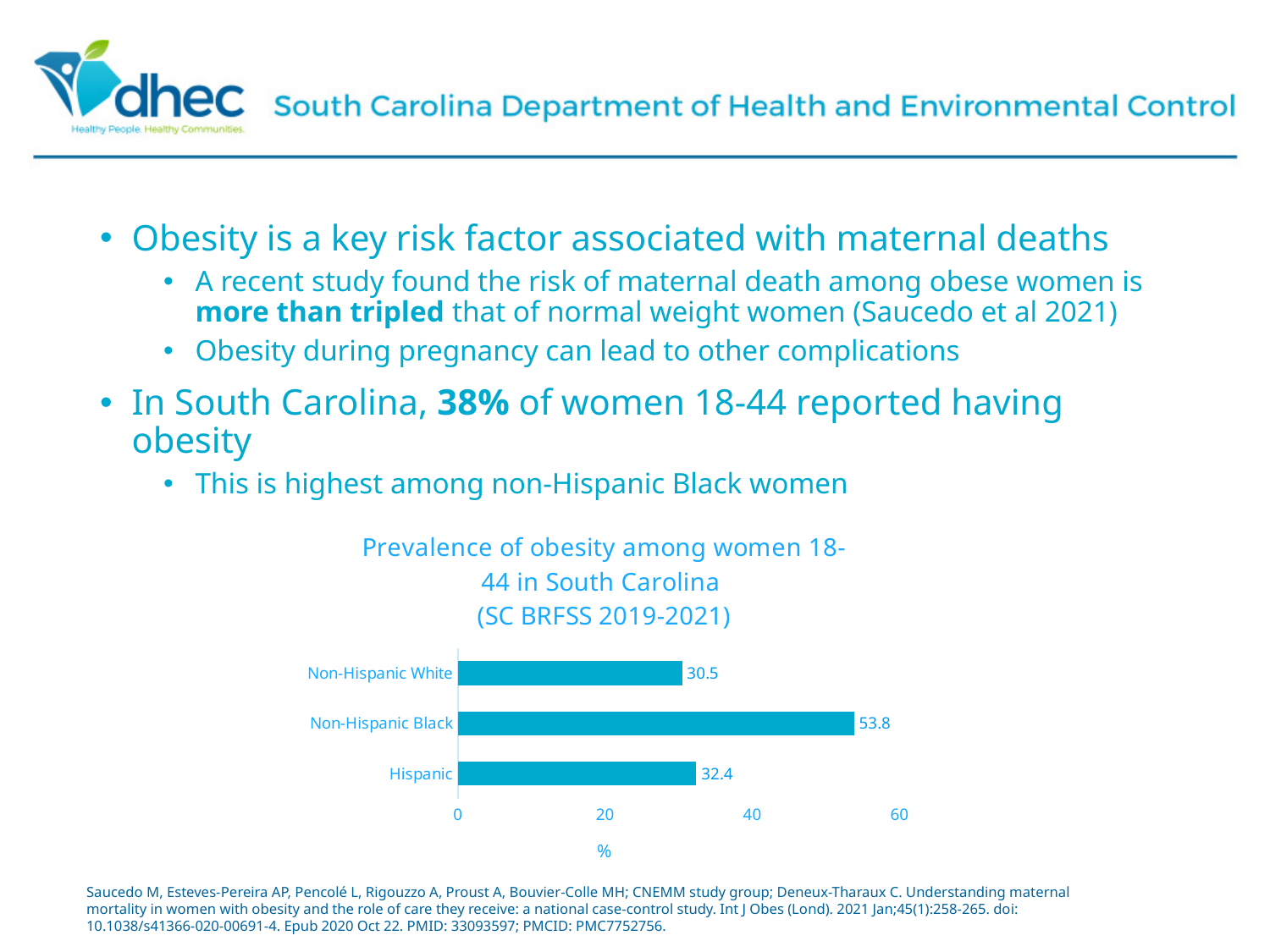
Is the value for Non-Hispanic Black women greater or less than 40? greater What is the prevalence of obesity among Non-Hispanic Black women in the chart? 53.8 How many groups are shown in the chart? 3 What is the difference between the values for Hispanic and Non-Hispanic White women? 1.9 What is the prevalence of obesity among Hispanic women in the chart? 32.4 What is the difference between the values for Non-Hispanic Black and Non-Hispanic White women? 23.3 What is the prevalence of obesity among Non-Hispanic White women in the chart? 30.5 Which is larger, the value for Hispanic women or the value for Non-Hispanic White women? Hispanic What is the label on the horizontal axis of the chart? % Which group has the highest prevalence of obesity in the chart? Non-Hispanic Black Which group has the lowest prevalence of obesity in the chart? Non-Hispanic White What kind of chart is shown on the slide? Bar chart